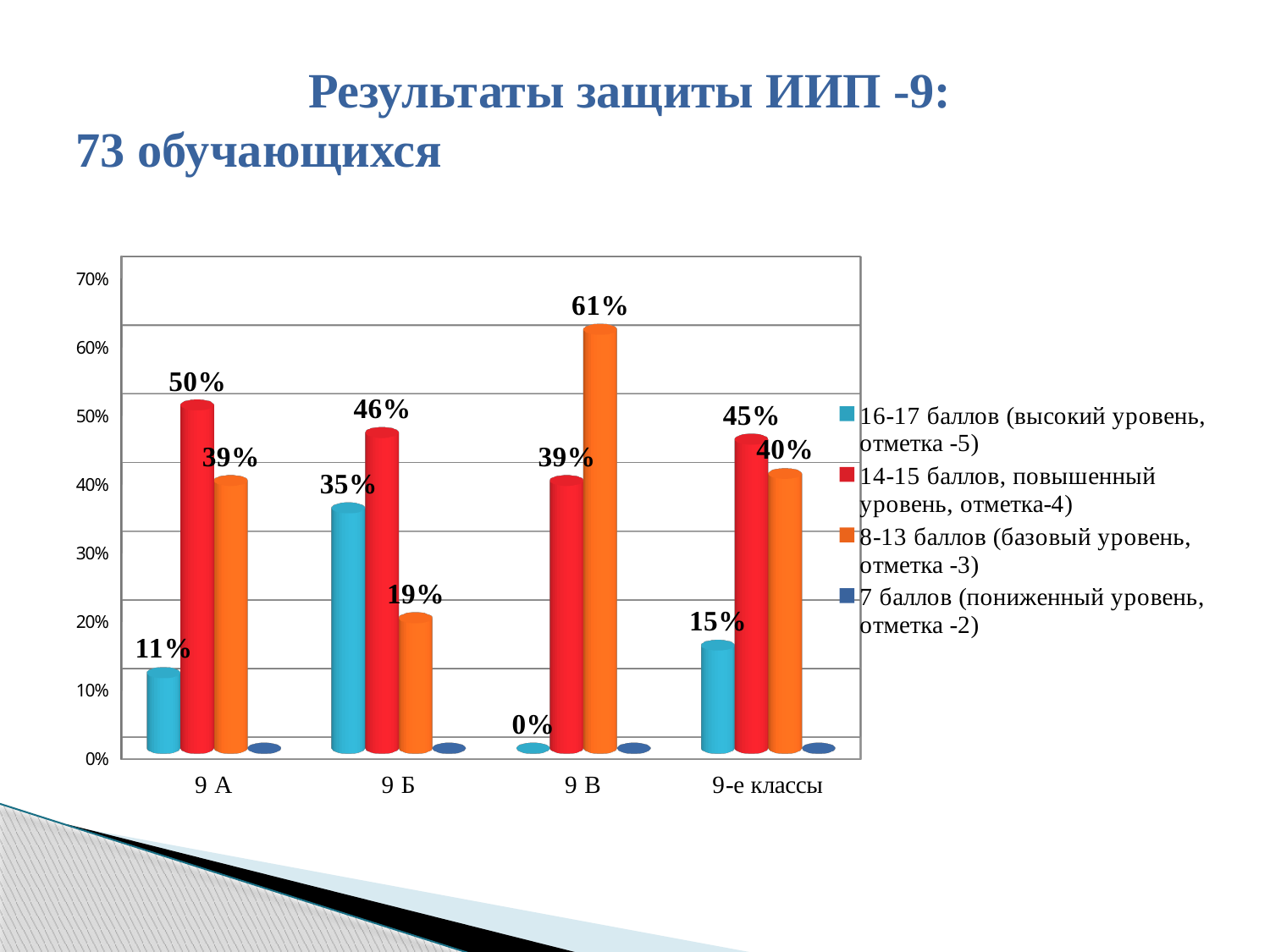
How many categories are shown on the x axis? 4 What is the difference between the "8-13 баллов" values for 9 В and 9 Б? 42% How many series does the legend list? 4 Which category has the lowest value in the series "16-17 баллов (высокий уровень, отметка -5)"? 9 В What kind of chart is shown on the slide? bar chart What is the value for 9 А in the series "14-15 баллов, повышенный уровень, отметка-4"? 50% What is the title of the slide? Результаты защиты ИИП -9: 73 обучающихся Which is larger for 9 Б: the "14-15 баллов" value or the "8-13 баллов" value? 14-15 баллов What is the value for 9-е классы in the series "16-17 баллов (высокий уровень, отметка -5)"? 15% What is the value for 9 В in the series "8-13 баллов (базовый уровень, отметка -3)"? 61% Which category has the highest value in the series "8-13 баллов (базовый уровень, отметка -3)"? 9 В What is the value for 9 Б in the series "16-17 баллов (высокий уровень, отметка -5)"? 35%